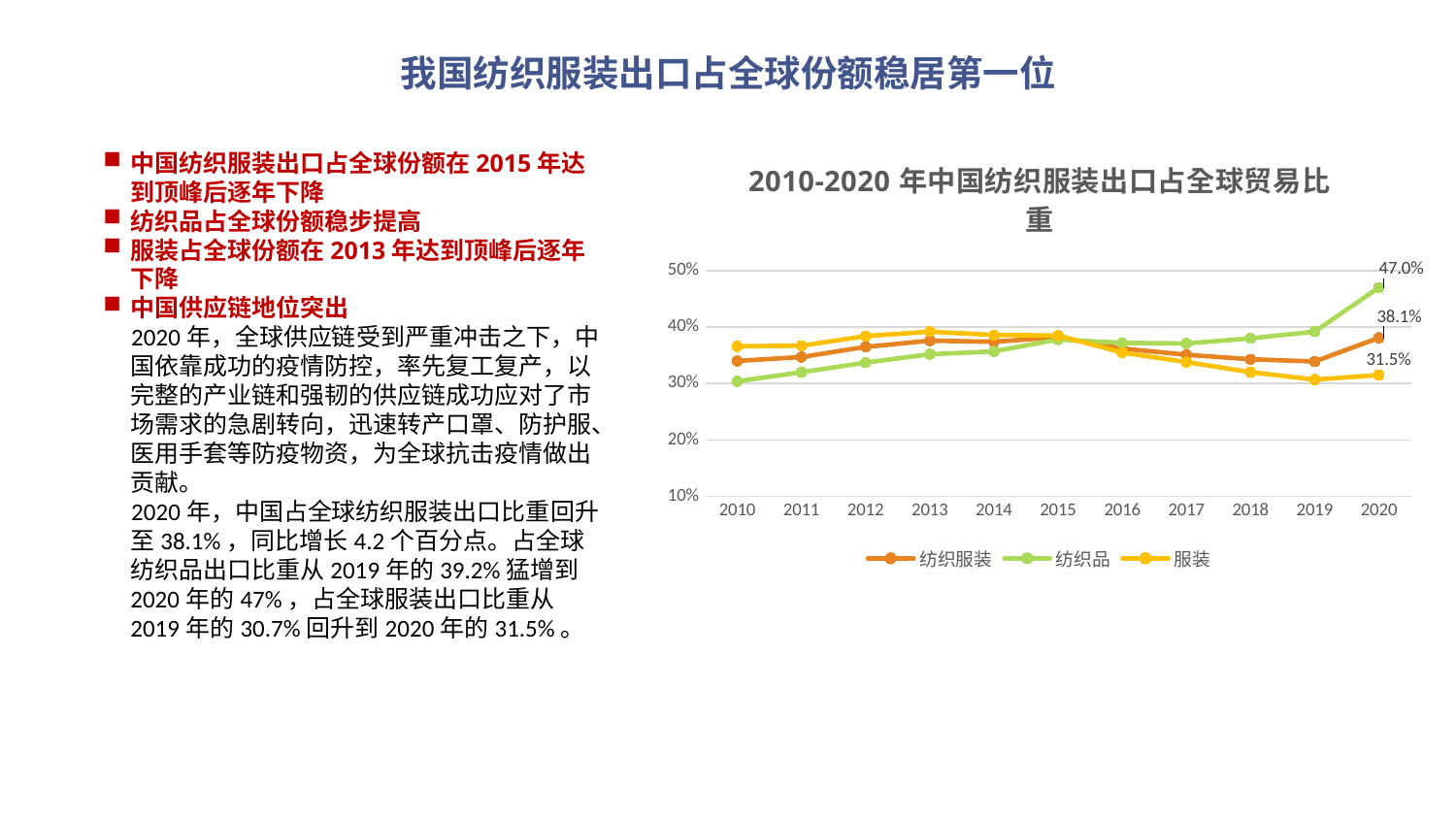
What is the value for 服装 in 2020? 31.5% What type of chart is shown on the slide? Line chart What is the difference between the 2020 values for 纺织品 and 纺织服装? 8.9 percentage points What is the value for 纺织服装 in 2020? 38.1% Which series has the lowest value in 2020? 服装 What is the value for 纺织品 in 2020? 47.0% What is the title of the chart? 2010-2020 年中国纺织服装出口占全球贸易比重 Is the value for 纺织品 in 2010 greater or less than 40%? less Does the 纺织品 series rise or fall overall from 2010 to 2020? Rise Which series has the highest value in 2020? 纺织品 How many years are plotted along the x axis of the chart? 11 How many series does the chart legend list? 3